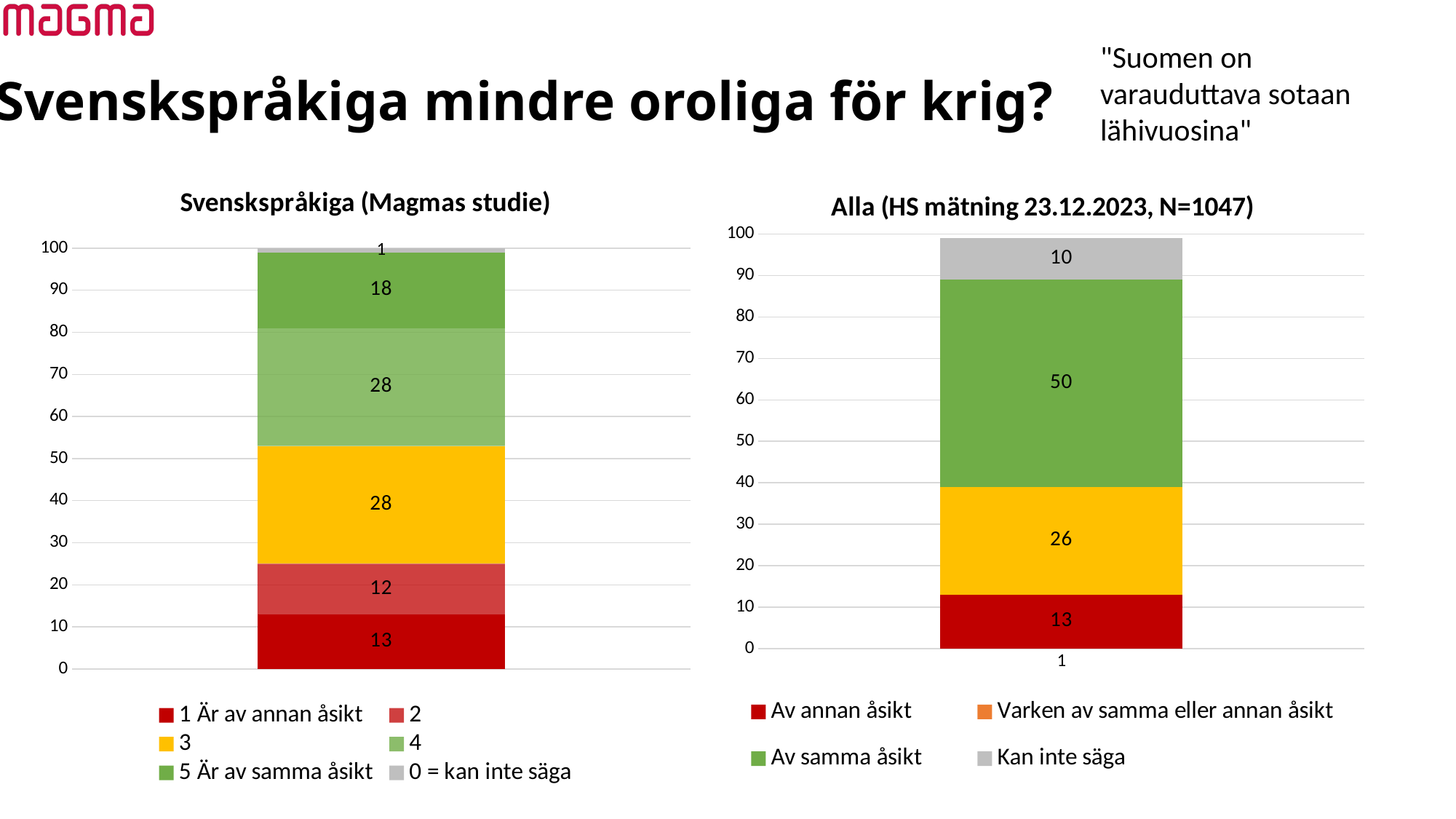
How many series does the legend of the chart titled "Svenskspråkiga (Magmas studie)" list? 6 In the chart titled "Svenskspråkiga (Magmas studie)", what is the value of the "1 Är av annan åsikt" segment? 13 In the chart titled "Alla (HS mätning 23.12.2023, N=1047)", which segment has the largest value? Av samma åsikt What is the difference between the "Av samma åsikt" value in the right chart and the "5 Är av samma åsikt" value in the left chart? 32 In the chart titled "Svenskspråkiga (Magmas studie)", what is the value of the "5 Är av samma åsikt" segment? 18 In the chart titled "Svenskspråkiga (Magmas studie)", what is the value of the "0 = kan inte säga" segment? 1 In the chart titled "Svenskspråkiga (Magmas studie)", what is the total of the stacked bar? 100 In the chart titled "Alla (HS mätning 23.12.2023, N=1047)", what is the value of the "Av samma åsikt" segment? 50 What kind of chart is the chart titled "Alla (HS mätning 23.12.2023, N=1047)"? Stacked bar chart In the chart titled "Alla (HS mätning 23.12.2023, N=1047)", what is the total of the stacked bar? 99 In the chart titled "Svenskspråkiga (Magmas studie)", which segment has the smallest value? 0 = kan inte säga In the chart titled "Alla (HS mätning 23.12.2023, N=1047)", what is the value of the "Kan inte säga" segment? 10